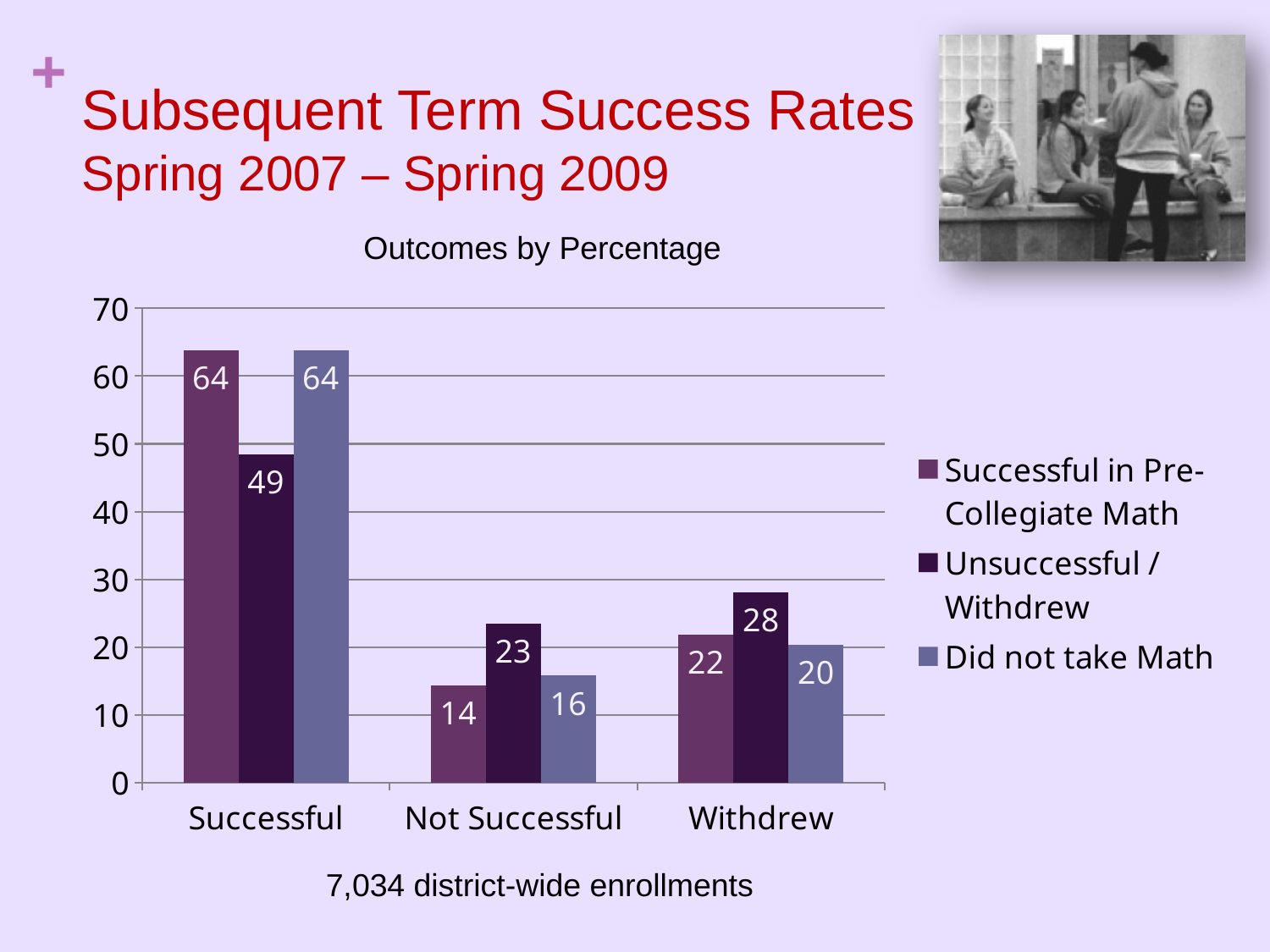
What is the value for "Did not take Math" in the Not Successful category? 16 Is the "Unsuccessful / Withdrew" value in the Successful category greater or less than 40? greater What kind of chart is shown on the slide? bar chart What is the value for "Unsuccessful / Withdrew" in the Successful category? 49 What is the value for "Successful in Pre-Collegiate Math" in the Withdrew category? 22 What is the title of the chart? Outcomes by Percentage What is the difference between the "Successful in Pre-Collegiate Math" and "Unsuccessful / Withdrew" values in the Successful category? 15 How many series does the legend list? 3 How many categories are shown on the x axis? 3 Which series has the lowest value in the Not Successful category? Successful in Pre-Collegiate Math Which is larger: the "Unsuccessful / Withdrew" value for Not Successful or for Withdrew? Withdrew Which series has the highest value in the Withdrew category? Unsuccessful / Withdrew